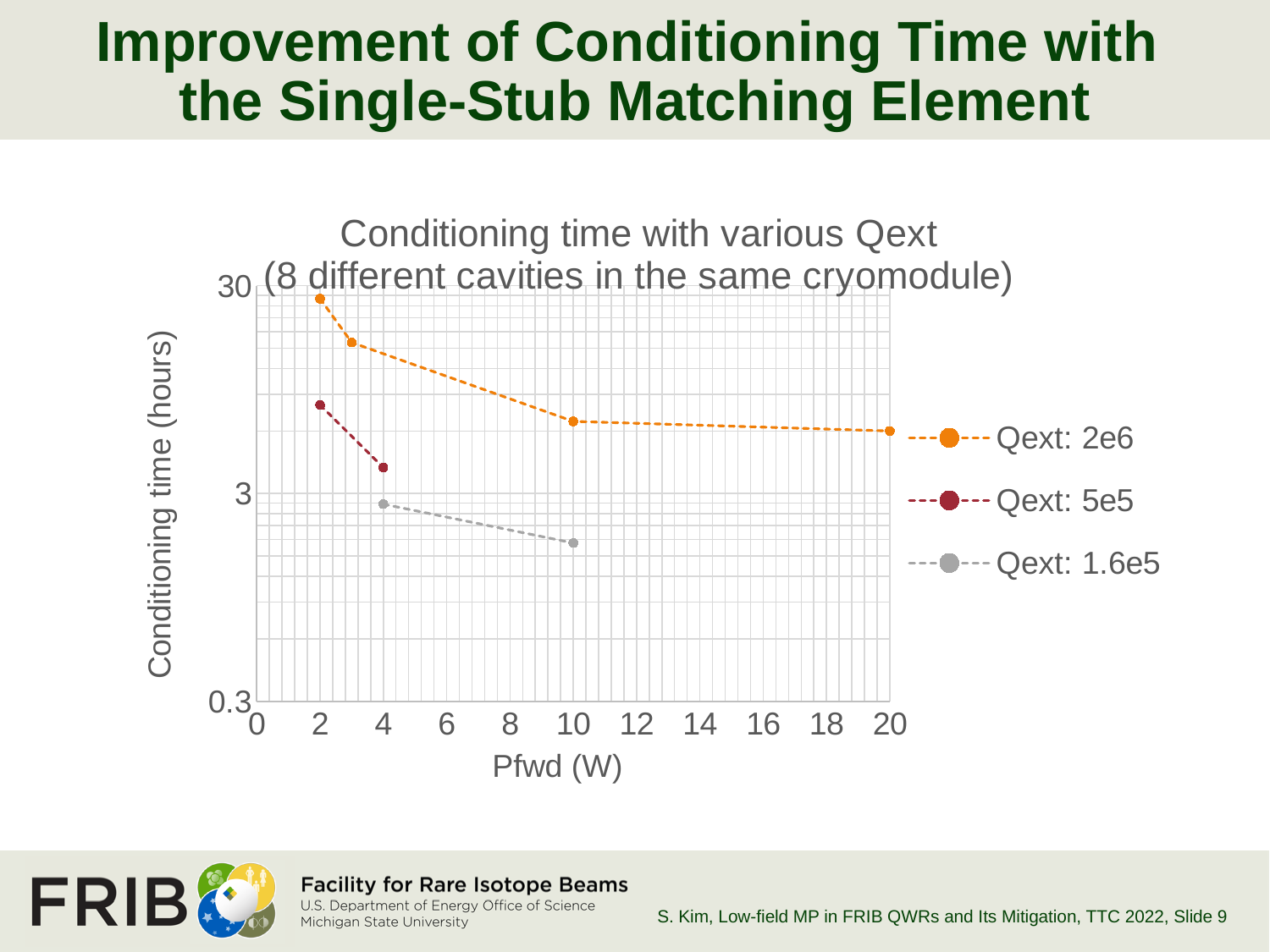
At Pfwd 4 W, which series has the lowest conditioning time? Qext: 1.6e5 Does the conditioning time for Qext: 2e6 rise or fall as Pfwd increases? Fall What kind of chart is shown on the slide? Line chart How many data points are plotted for the Qext: 5e5 series? 2 How many data points are plotted for the Qext: 2e6 series? 4 Is the conditioning time for Qext: 2e6 at Pfwd 2 W greater or less than 3 hours? greater Is the conditioning time for Qext: 5e5 at Pfwd 2 W greater or less than 3 hours? greater What is the label of the x axis of the chart? Pfwd (W) Is the conditioning time for Qext: 1.6e5 at Pfwd 10 W greater or less than 3 hours? less At Pfwd 4 W, is the conditioning time larger for Qext: 5e5 or Qext: 1.6e5? Qext: 5e5 How many series does the legend list? 3